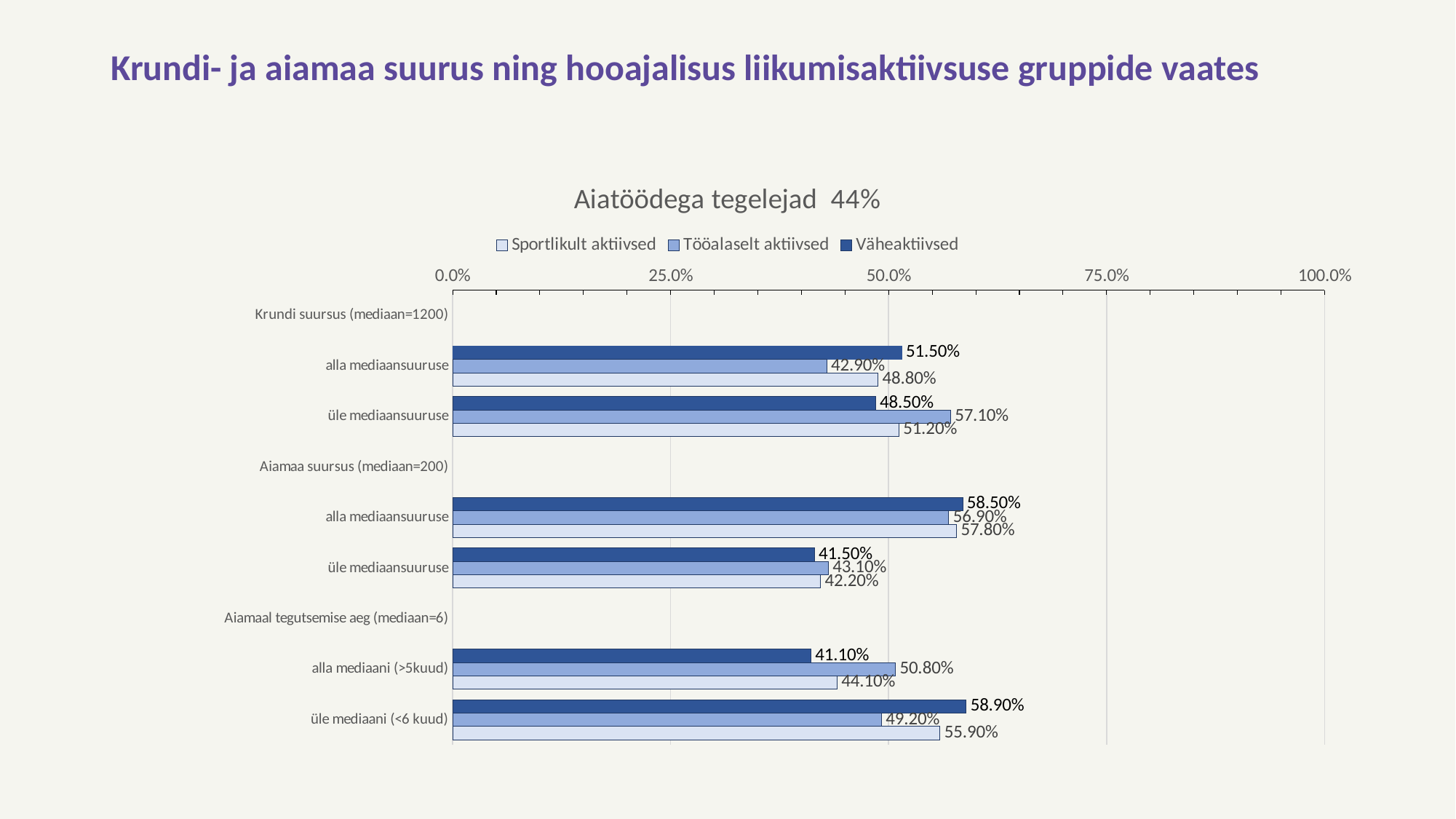
What is the value for Tööalaselt aktiivsed in the 'üle mediaansuuruse' category under Krundi suursus (mediaan=1200)? 57.10% What is the value for Sportlikult aktiivsed in the 'üle mediaani (<6 kuud)' category? 55.90% What is the title of the chart? Aiatöödega tegelejad 44% Which series has the lowest value in the 'alla mediaani (>5kuud)' category? Väheaktiivsed Which series has the highest value in the 'alla mediaansuuruse' category under Aiamaa suursus (mediaan=200)? Väheaktiivsed What is the value for Väheaktiivsed in the 'alla mediaani (>5kuud)' category? 41.10% What kind of chart is shown on the slide? bar chart Which is larger: the Väheaktiivsed value for 'üle mediaani (<6 kuud)' or the Väheaktiivsed value for 'alla mediaani (>5kuud)'? üle mediaani (<6 kuud) What is the difference between the Väheaktiivsed and Tööalaselt aktiivsed values in the 'alla mediaansuuruse' category under Krundi suursus (mediaan=1200)? 8.60% Is the Sportlikult aktiivsed value for 'üle mediaansuuruse' under Aiamaa suursus (mediaan=200) greater or less than 50.0%? less What is the value for Väheaktiivsed in the 'alla mediaansuuruse' category under Krundi suursus (mediaan=1200)? 51.50% How many series does the legend list? 3